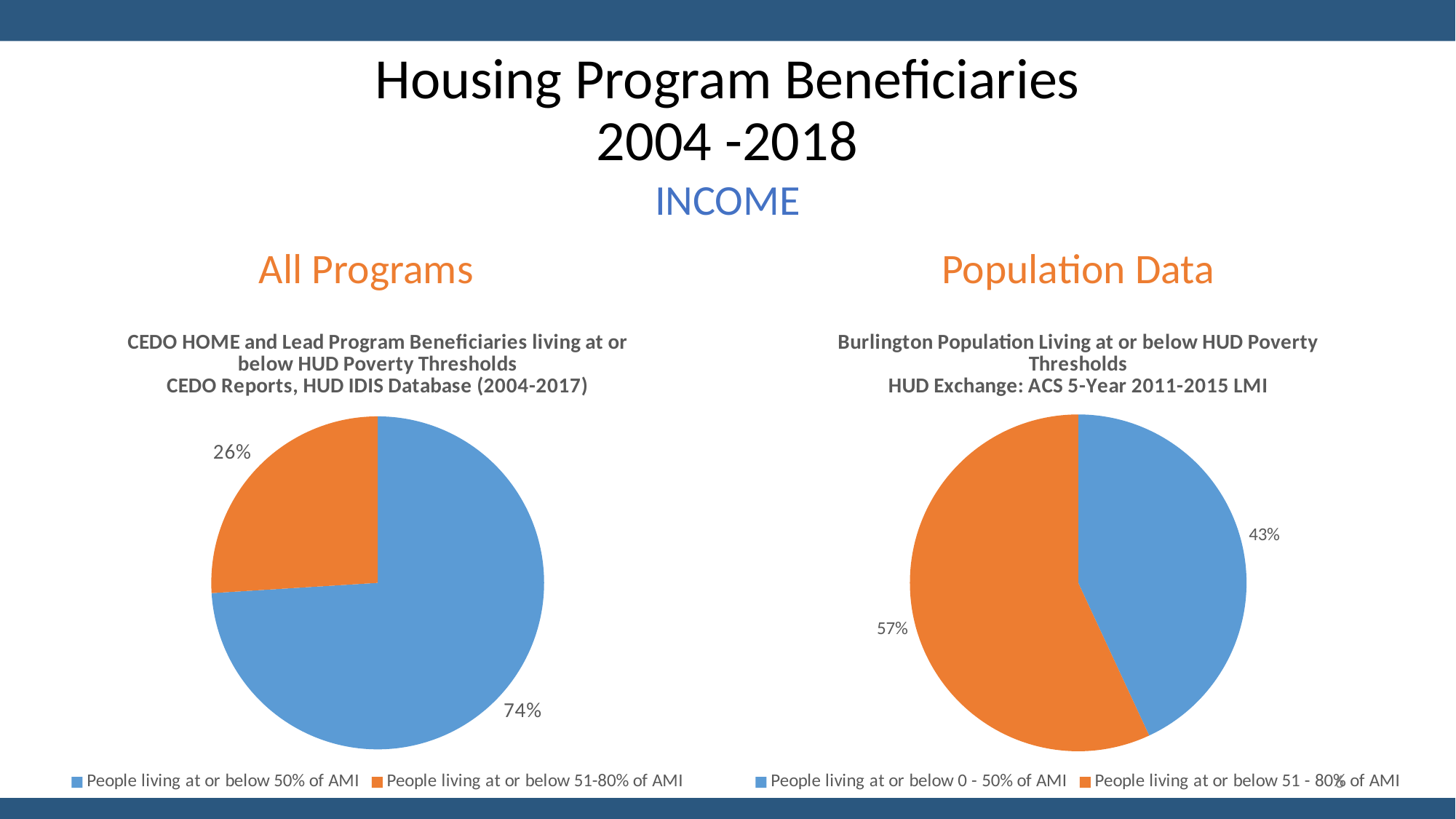
In the All Programs pie chart on the left, what share of beneficiaries are people living at or below 51-80% of AMI? 26% In the All Programs pie chart on the left, what share of beneficiaries are people living at or below 50% of AMI? 74% In the Population Data pie chart on the right, what share of the Burlington population is living at or below 51 - 80% of AMI? 57% In the Population Data pie chart on the right, what is the difference in percentage points between the two slices? 14 Which is larger: the share of people at or below 50% of AMI in the All Programs chart on the left, or the share at or below 0 - 50% of AMI in the Population Data chart on the right? All Programs (74%) In the All Programs pie chart on the left, what colour is the slice for people living at or below 51-80% of AMI? Orange In the All Programs pie chart on the left, what is the difference in percentage points between the two slices? 48 In the All Programs pie chart on the left, which category has the largest slice? People living at or below 50% of AMI What type of chart is used on the left under All Programs? Pie chart In the Population Data pie chart on the right, which category has the smallest slice? People living at or below 0 - 50% of AMI How many slices does the Population Data pie chart on the right have? 2 In the Population Data pie chart on the right, what share of the Burlington population is living at or below 0 - 50% of AMI? 43%